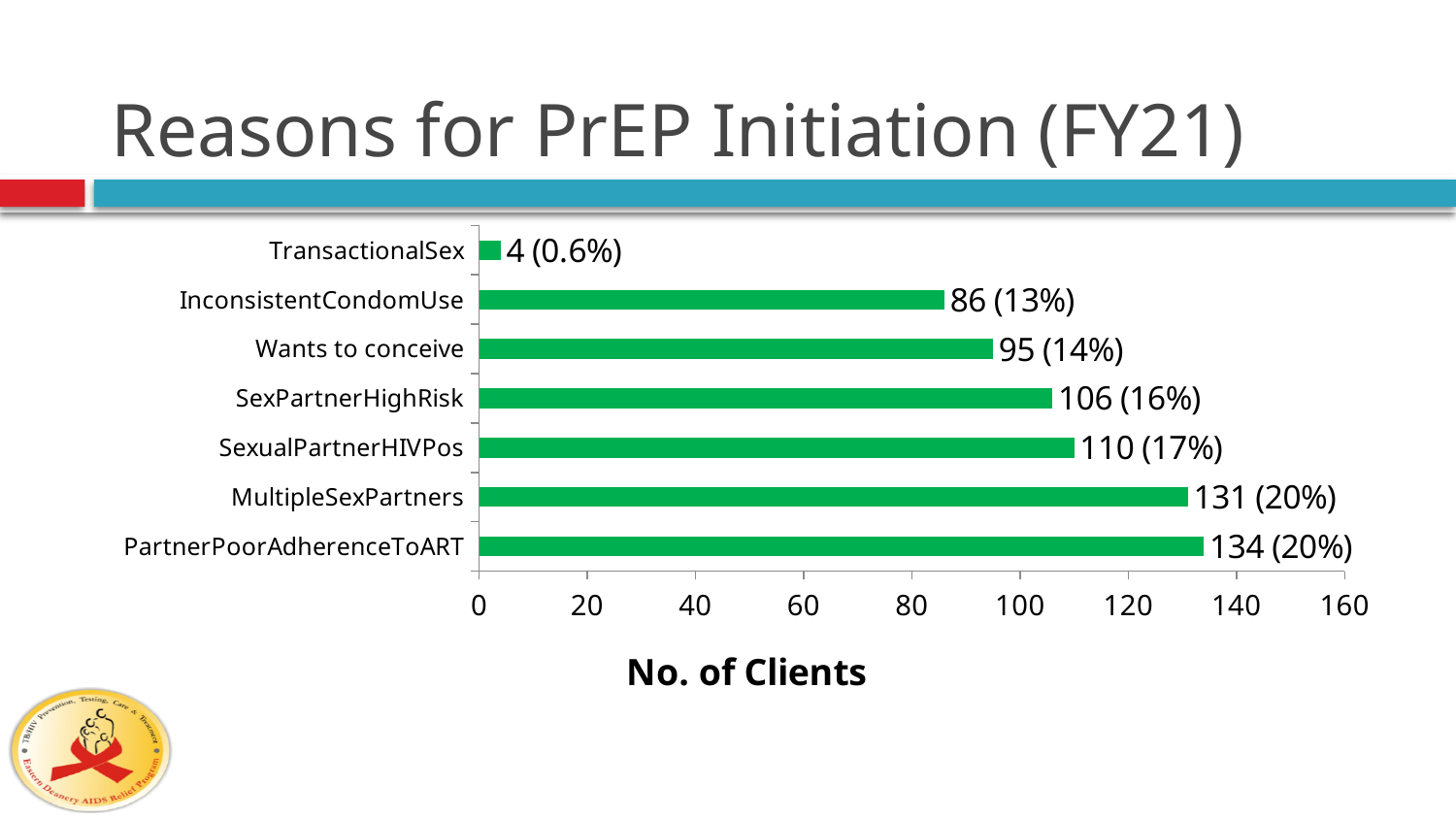
What is the number of clients for TransactionalSex? 4 (0.6%) What is the title of the slide? Reasons for PrEP Initiation (FY21) Which reason has the highest number of clients? PartnerPoorAdherenceToART Which reason has the lowest number of clients? TransactionalSex Is the value for InconsistentCondomUse greater or less than 100? less What is the difference in number of clients between MultipleSexPartners and InconsistentCondomUse? 45 What is the number of clients for SexualPartnerHIVPos? 110 (17%) Which has more clients, SexPartnerHighRisk or Wants to conceive? SexPartnerHighRisk What is the number of clients for Wants to conceive? 95 (14%) How many reasons for PrEP initiation are shown in the chart? 7 What is the label of the horizontal axis? No. of Clients What kind of chart is shown on the slide? bar chart